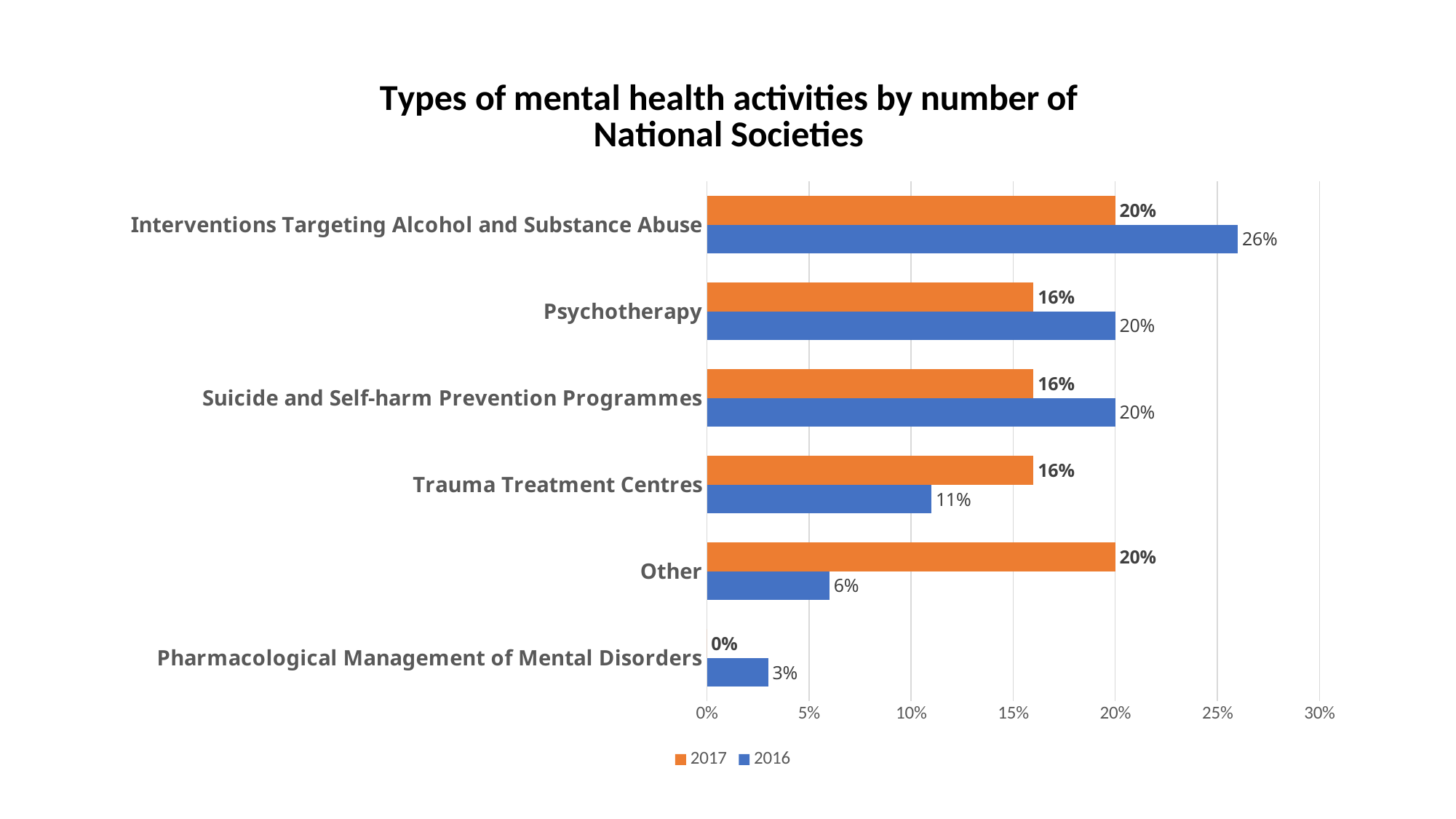
How many categories are shown on the chart? 6 Which colour represents the 2017 series? Orange What is the difference between the 2016 and 2017 values for Other? 14% What is the 2017 value for Pharmacological Management of Mental Disorders? 0% What is the 2017 value for Trauma Treatment Centres? 16% What is the 2016 value for Interventions Targeting Alcohol and Substance Abuse? 26% What kind of chart is shown on the slide? Bar chart What is the 2016 value for Other? 6% For Trauma Treatment Centres, which year has the larger value, 2016 or 2017? 2017 Which category has the highest 2016 value? Interventions Targeting Alcohol and Substance Abuse How many series does the legend list? 2 Which category has the lowest 2017 value? Pharmacological Management of Mental Disorders